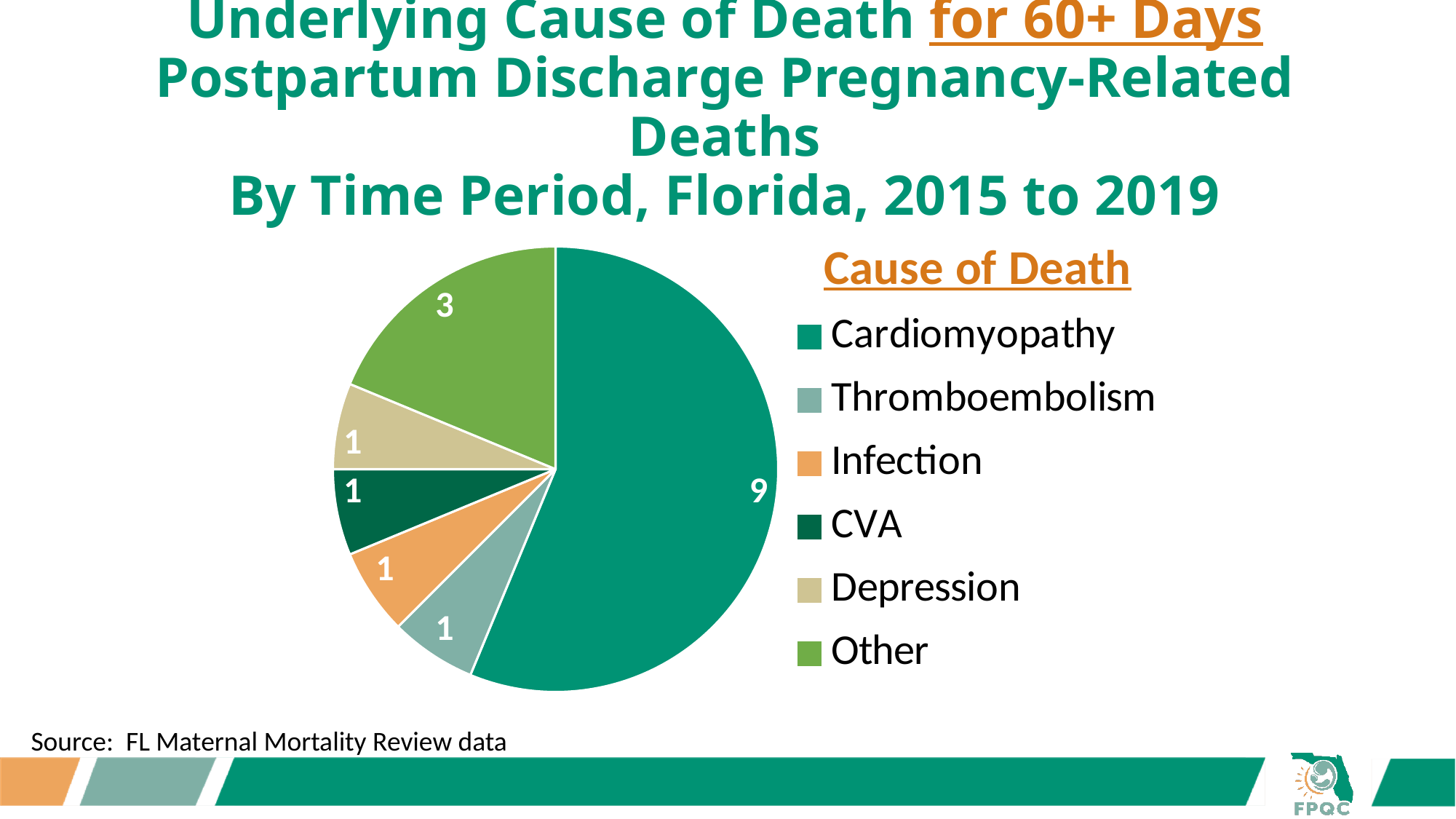
How many deaths are attributed to Thromboembolism? 1 Which is larger, the number of deaths from Other causes or from Infection? Other How many cause-of-death categories does the pie chart show? 6 What is the difference between the number of Cardiomyopathy deaths and Other deaths? 6 What is the title of the legend on the slide? Cause of Death How many deaths are attributed to Cardiomyopathy? 9 What share of the total deaths does the Other category represent? 18.75% Which cause of death has the largest slice of the pie? Cardiomyopathy What type of chart is shown on the slide? Pie chart What is the total number of deaths represented in the pie chart? 16 What share of the total deaths does Cardiomyopathy represent? 56.25% How many deaths are attributed to Other causes? 3